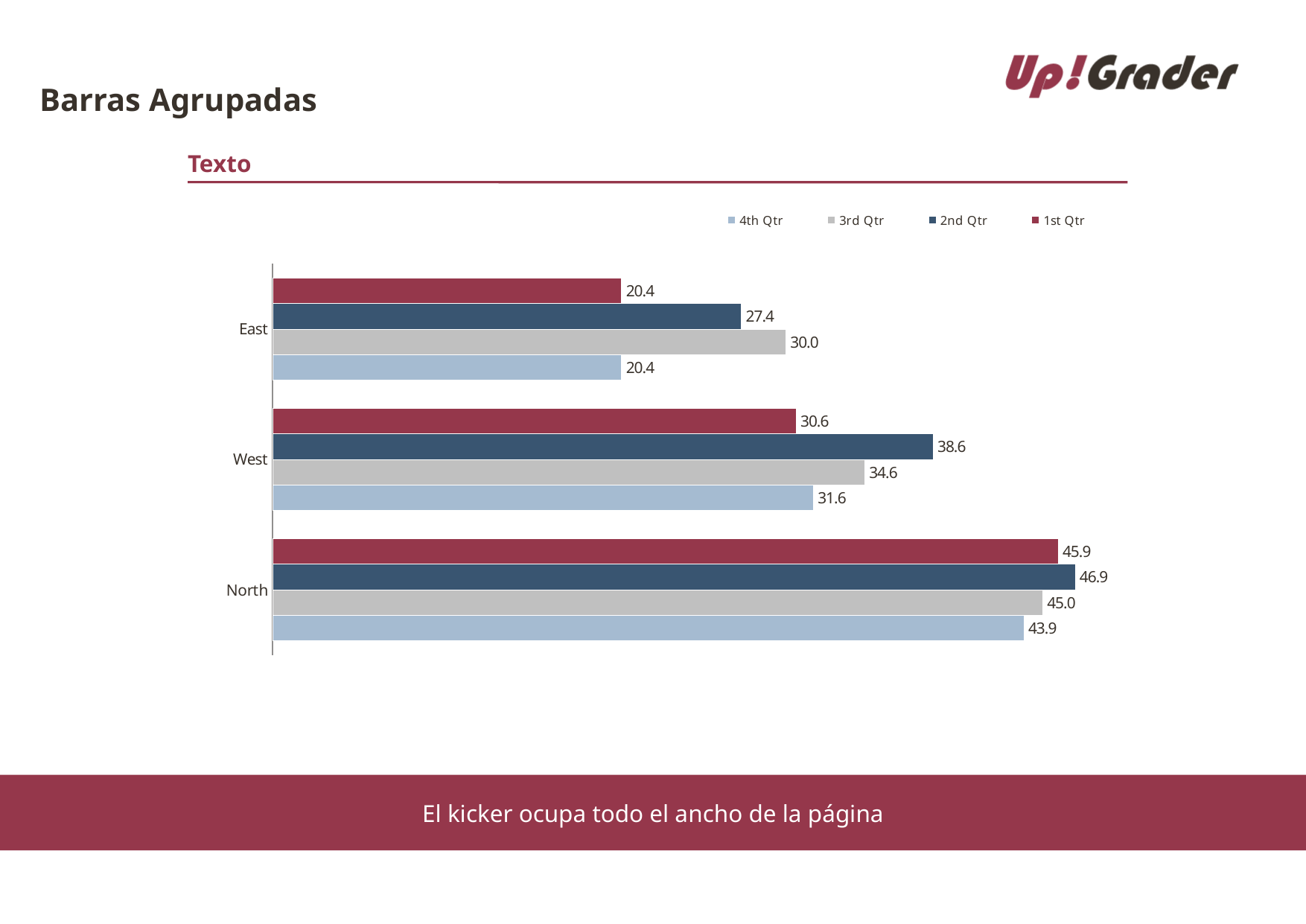
What is the value for 3rd Qtr in the East category? 30.0 Which category has the highest 1st Qtr value? North Which series has the lowest value in the West category? 1st Qtr How many series does the legend list? 4 Which is larger: the 3rd Qtr value for West or the 4th Qtr value for West? 3rd Qtr for West What is the value for 4th Qtr in the North category? 43.9 What is the difference between the 2nd Qtr and 1st Qtr values for East? 7.0 What is the value for 2nd Qtr in the West category? 38.6 How many categories are shown on the chart? 3 What kind of chart is shown on the slide? Bar chart What is the value for 1st Qtr in the West category? 30.6 What is the difference between the 2nd Qtr values for North and West? 8.3